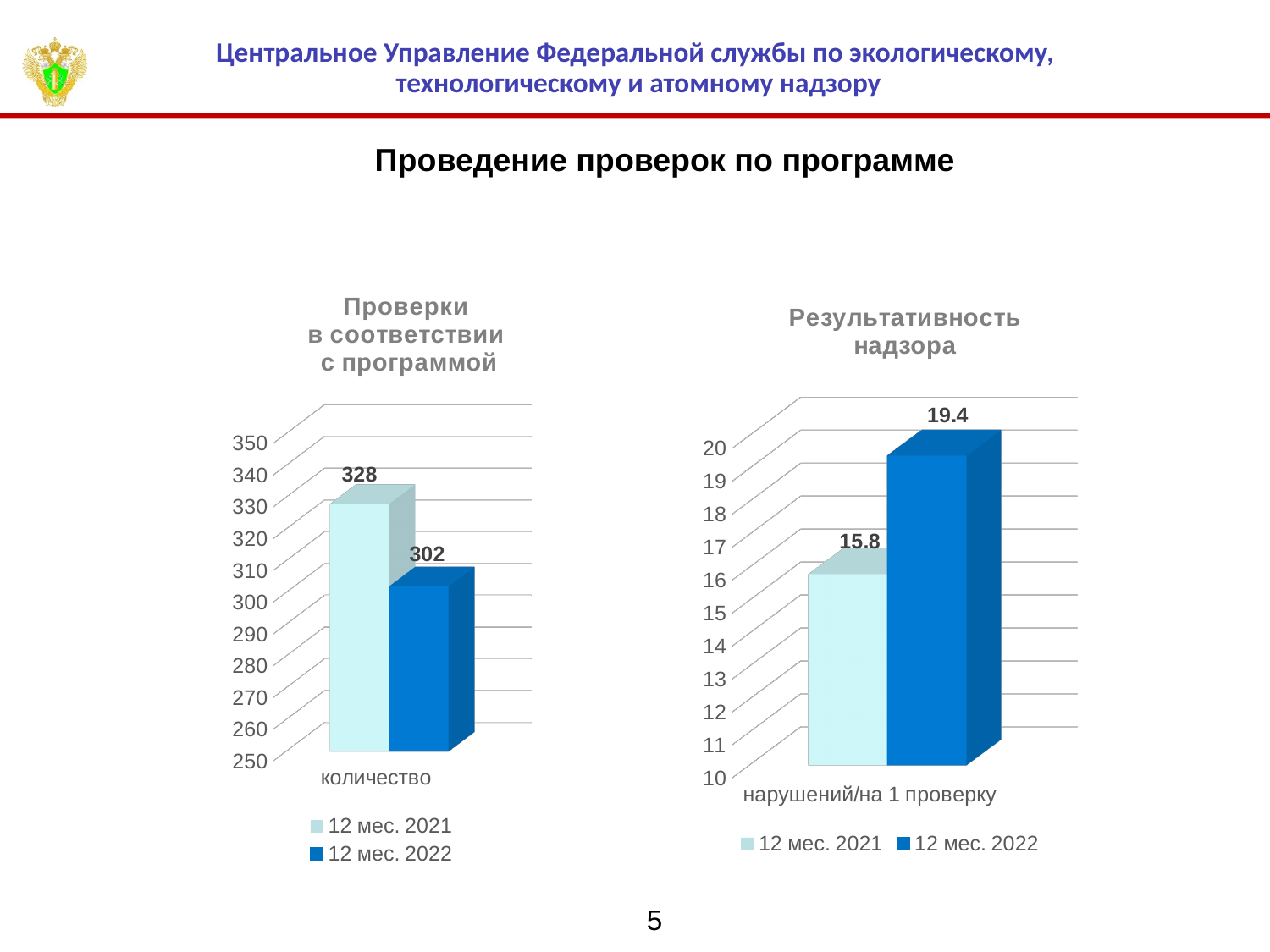
In the chart titled "Результативность надзора", how many series does the legend list? 2 In the chart titled "Результативность надзора", what is the value for 12 мес. 2022? 19.4 What kind of chart is the chart titled "Проверки в соответствии с программой"? Bar chart In the chart titled "Проверки в соответствии с программой", which series has the higher value, 12 мес. 2021 or 12 мес. 2022? 12 мес. 2021 In the chart titled "Проверки в соответствии с программой", what is the value for 12 мес. 2021? 328 In the chart titled "Проверки в соответствии с программой", what is the category label on the x axis? количество In the chart titled "Результативность надзора", what is the value for 12 мес. 2021? 15.8 In the chart titled "Проверки в соответствии с программой", what is the value for 12 мес. 2022? 302 In the chart titled "Результативность надзора", which series has the higher value? 12 мес. 2022 In the chart titled "Результативность надзора", what is the category label on the x axis? нарушений/на 1 проверку In the chart titled "Проверки в соответствии с программой", what is the difference between the 12 мес. 2021 and 12 мес. 2022 values? 26 In the chart titled "Результативность надзора", what is the difference between the 12 мес. 2022 and 12 мес. 2021 values? 3.6